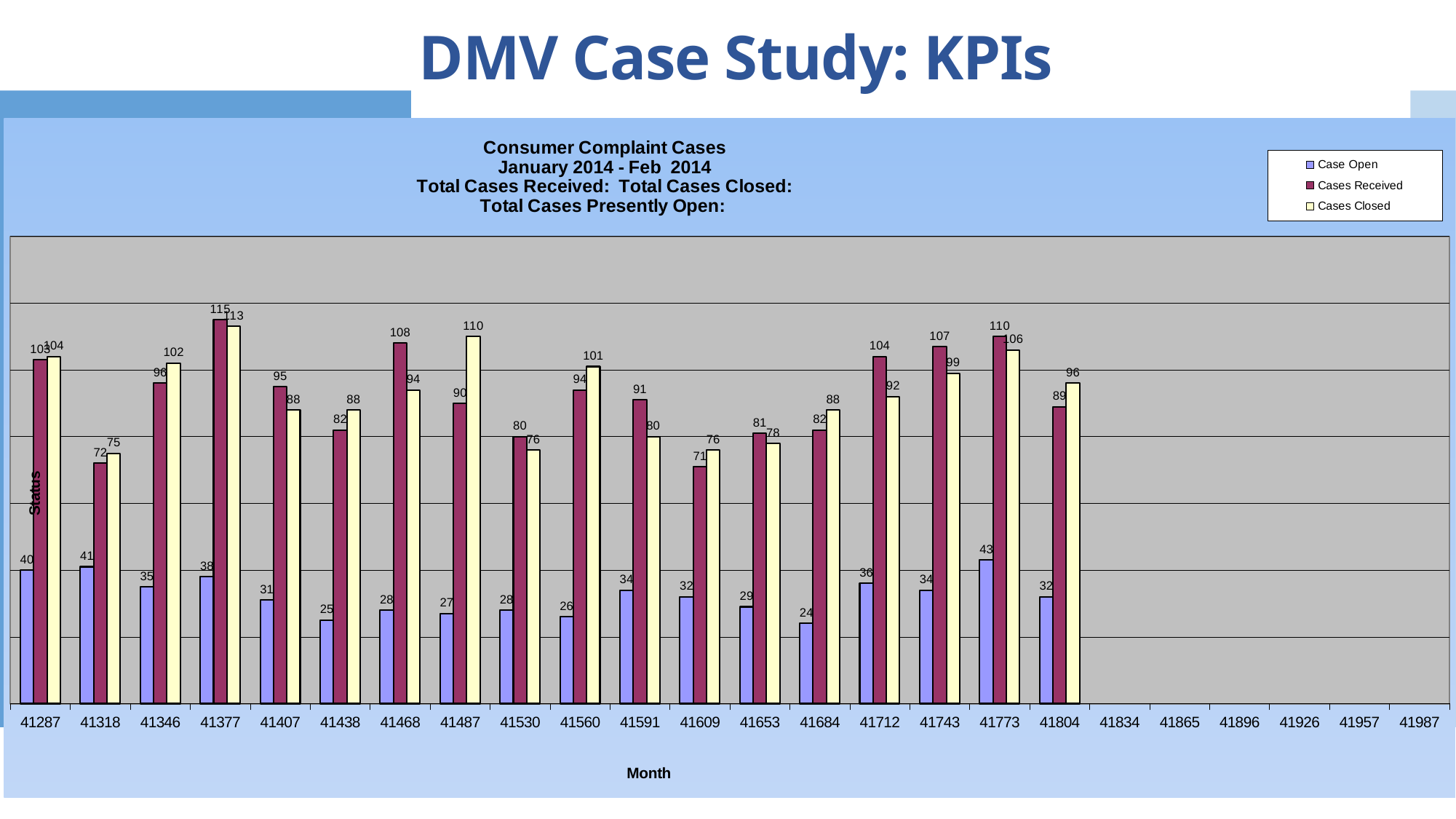
What kind of chart is shown on the slide? Bar chart What is the value of Case Open for category 41684? 24 Which category has the highest Case Open value? 41773 For category 41468, which is larger: Cases Received or Cases Closed? Cases Received What is the difference between Cases Closed and Cases Received for category 41487? 20 Which category has the lowest Cases Received value? 41609 How many series does the legend list? 3 What is the title of the x axis? Month How many categories on the x axis have bars plotted? 18 Which category has the lowest Cases Closed value? 41318 What is the value of Cases Received for category 41377? 115 What is the value of Cases Closed for category 41487? 110